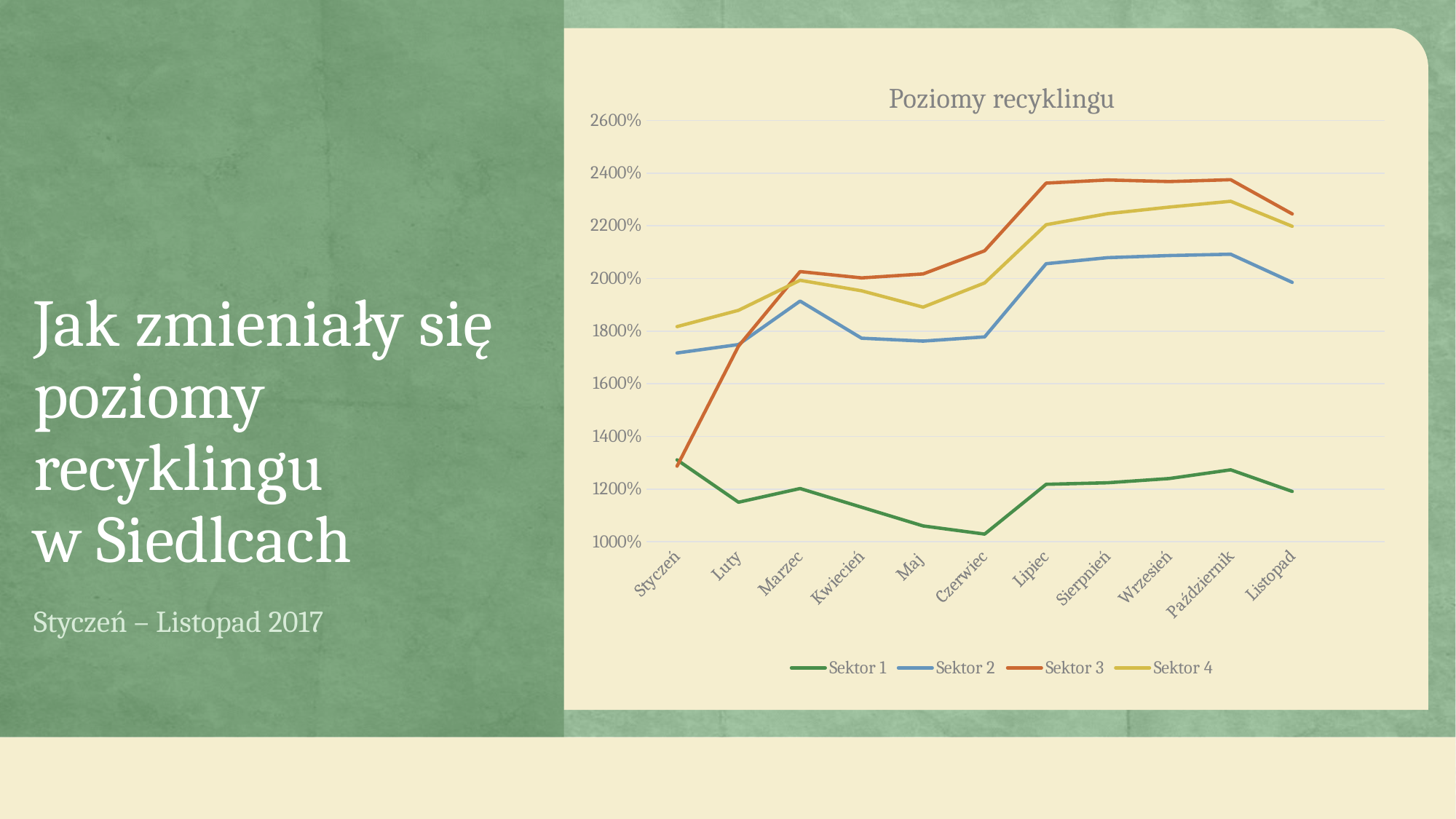
Which is larger in Styczeń, Sektor 3 or Sektor 4? Sektor 4 Is the value for Sektor 1 in Czerwiec greater or less than 1200%? less What kind of chart is shown on the slide? line chart Is the value for Sektor 3 in Lipiec greater or less than 2200%? greater How many series does the legend list? 4 Which series has the highest value in Październik? Sektor 3 How many months are shown on the x axis? 11 What is the title of the chart? Poziomy recyklingu Which series has the lowest value in Listopad? Sektor 1 In which month does Sektor 4 have its lowest value? Styczeń Does Sektor 3 rise or fall from Styczeń to Marzec? rise In which month does Sektor 1 reach its lowest value? Czerwiec